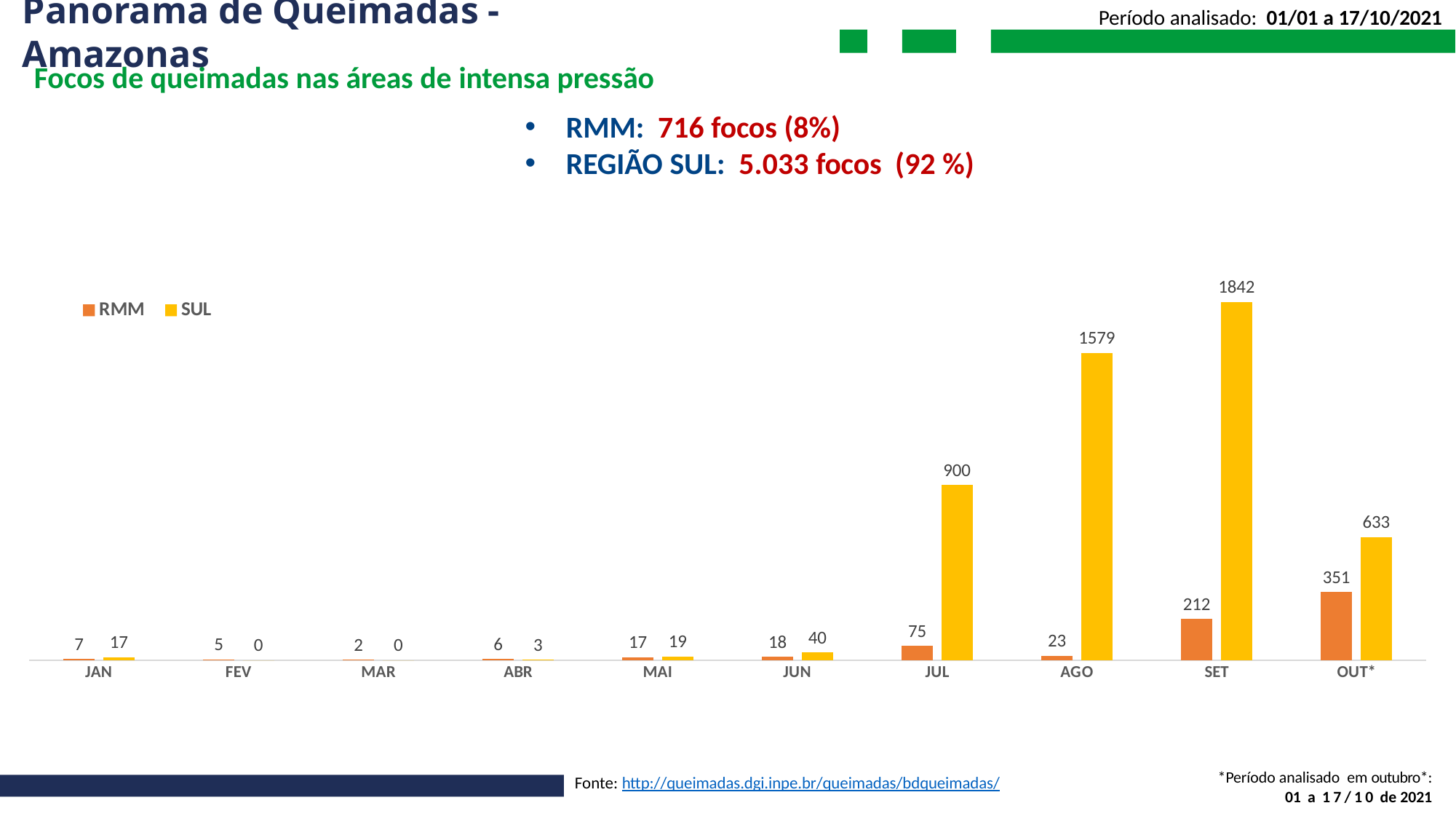
What is the SUL value for SET? 1842 What is the difference between the SUL and RMM values for SET? 1630 What kind of chart is shown on the slide? Bar chart Which is larger in AGO, the RMM value or the SUL value? SUL Which series is shown in yellow in the legend? SUL What is the RMM value for OUT*? 351 Which month has the highest SUL value? SET How many series does the legend list? 2 Which month has the lowest SUL value? FEV and MAR (both 0) What is the RMM value for AGO? 23 How many months are shown on the x axis? 10 What is the SUL value for JUL? 900